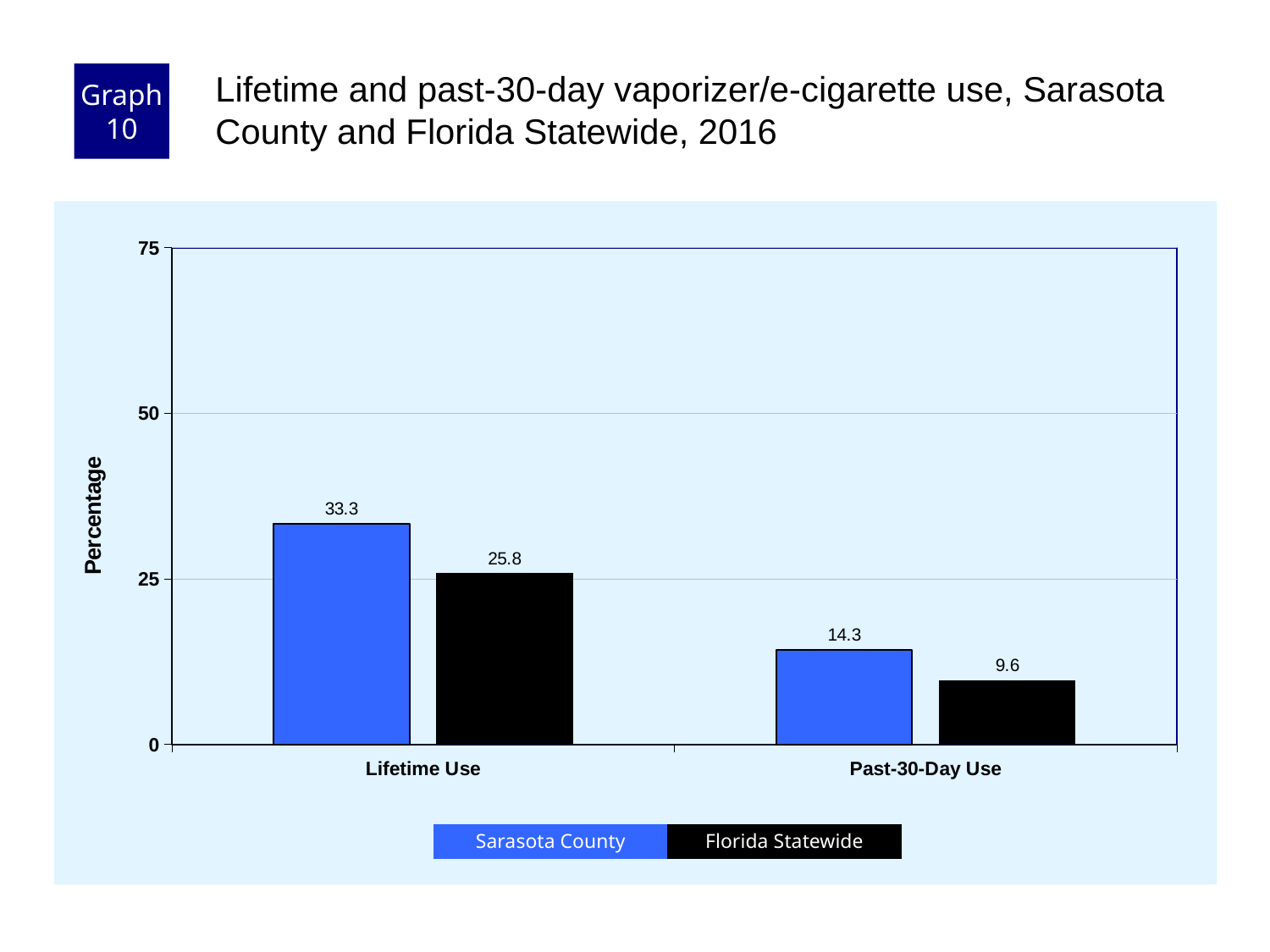
What is the difference between the Sarasota County and Florida Statewide values for Past-30-Day Use? 4.7 What is the difference between the Sarasota County and Florida Statewide values for Lifetime Use? 7.5 What is the Florida Statewide value for Lifetime Use? 25.8 How many series does the legend list? 2 What is the Sarasota County value for Past-30-Day Use? 14.3 What is the Florida Statewide value for Past-30-Day Use? 9.6 For Past-30-Day Use, which is larger: Sarasota County or Florida Statewide? Sarasota County What kind of chart is shown on the slide? Bar chart Which bar has the highest value on the chart? Sarasota County, Lifetime Use What is the label on the vertical axis? Percentage What is the Sarasota County value for Lifetime Use? 33.3 Which bar has the lowest value on the chart? Florida Statewide, Past-30-Day Use